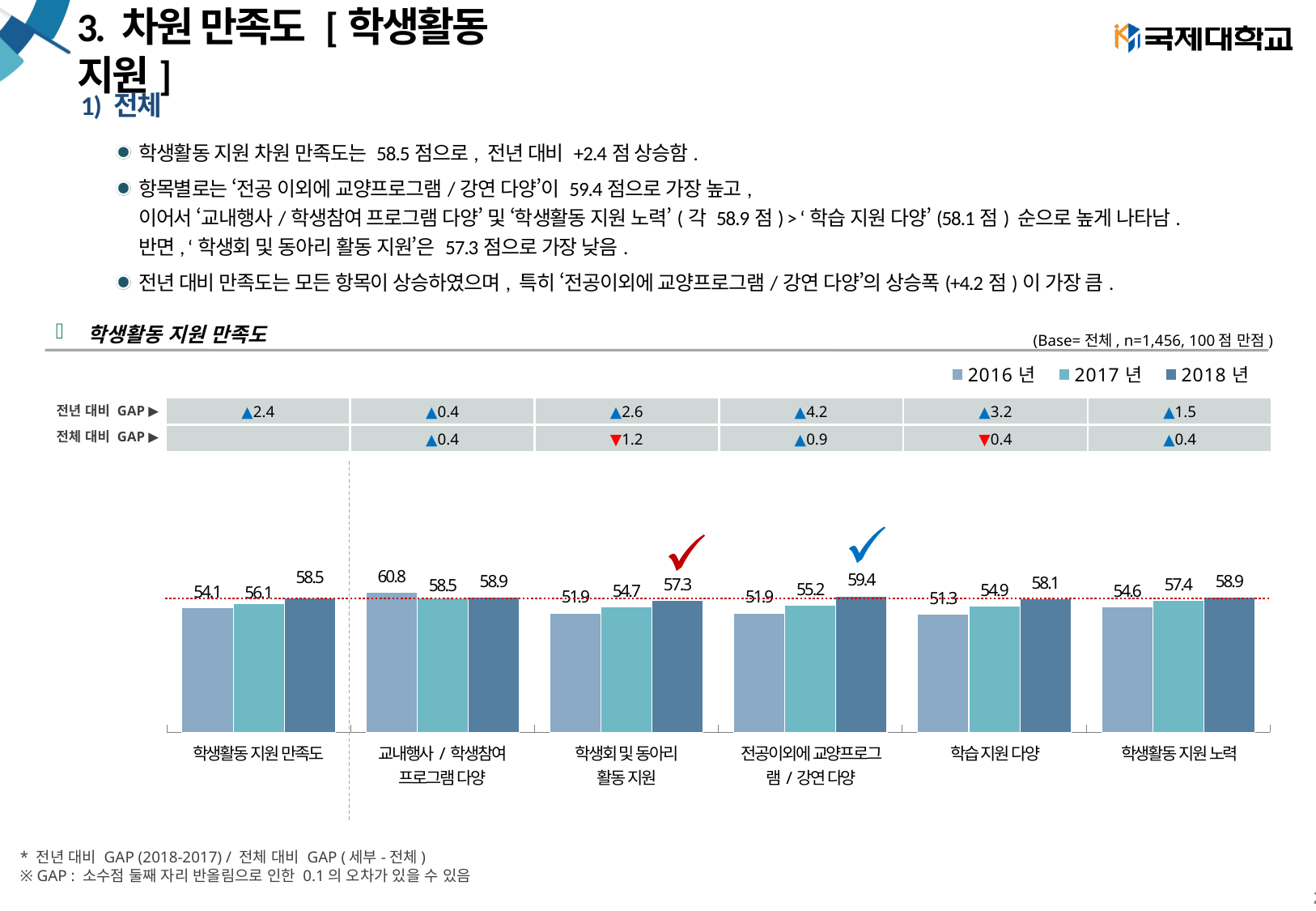
What kind of chart is shown on the slide? bar chart What is the difference between the 2018년 and 2017년 values for 전공이외에 교양프로그램 / 강연 다양? 4.2 Which category has the highest 2018년 value? 전공이외에 교양프로그램 / 강연 다양 Which category has the lowest 2018년 value? 학생회 및 동아리 활동 지원 What is the 2017년 value for 학습 지원 다양? 54.9 What is the 2018년 value for 학생활동 지원 만족도? 58.5 For 학생회 및 동아리 활동 지원, do the values rise or fall from 2016년 to 2018년? rise Which is larger for 교내행사 / 학생참여 프로그램 다양: the 2016년 value or the 2018년 value? 2016년 What is the title of the chart? 학생활동 지원 만족도 What is the 2016년 value for 교내행사 / 학생참여 프로그램 다양? 60.8 How many categories are shown on the x axis of the chart? 6 How many series does the legend list? 3